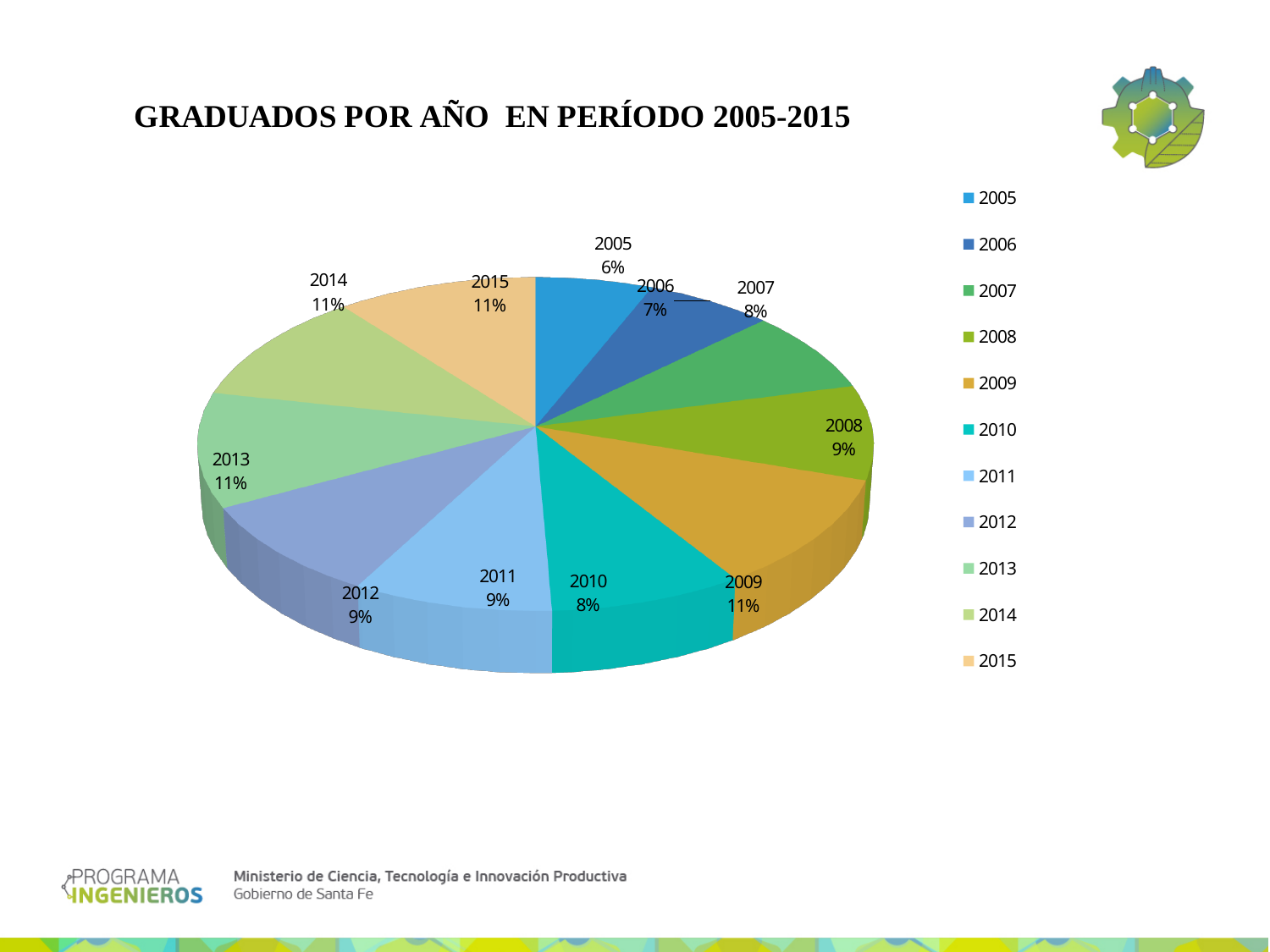
Which year has the smallest slice of the pie? 2005 How many entries does the legend list? 11 What percentage is shown for 2009? 11% What kind of chart is shown on the slide? pie chart What percentage is shown for 2010? 8% How many slices does the pie chart have? 11 Which is larger, the share for 2006 or the share for 2013? 2013 What percentage is shown for 2012? 9% What is the difference in percentage points between the share for 2009 and the share for 2005? 5 What is the title of the chart? GRADUADOS POR AÑO EN PERÍODO 2005-2015 What share of the pie does 2005 represent? 6% What is the combined share of 2014 and 2015? 22%